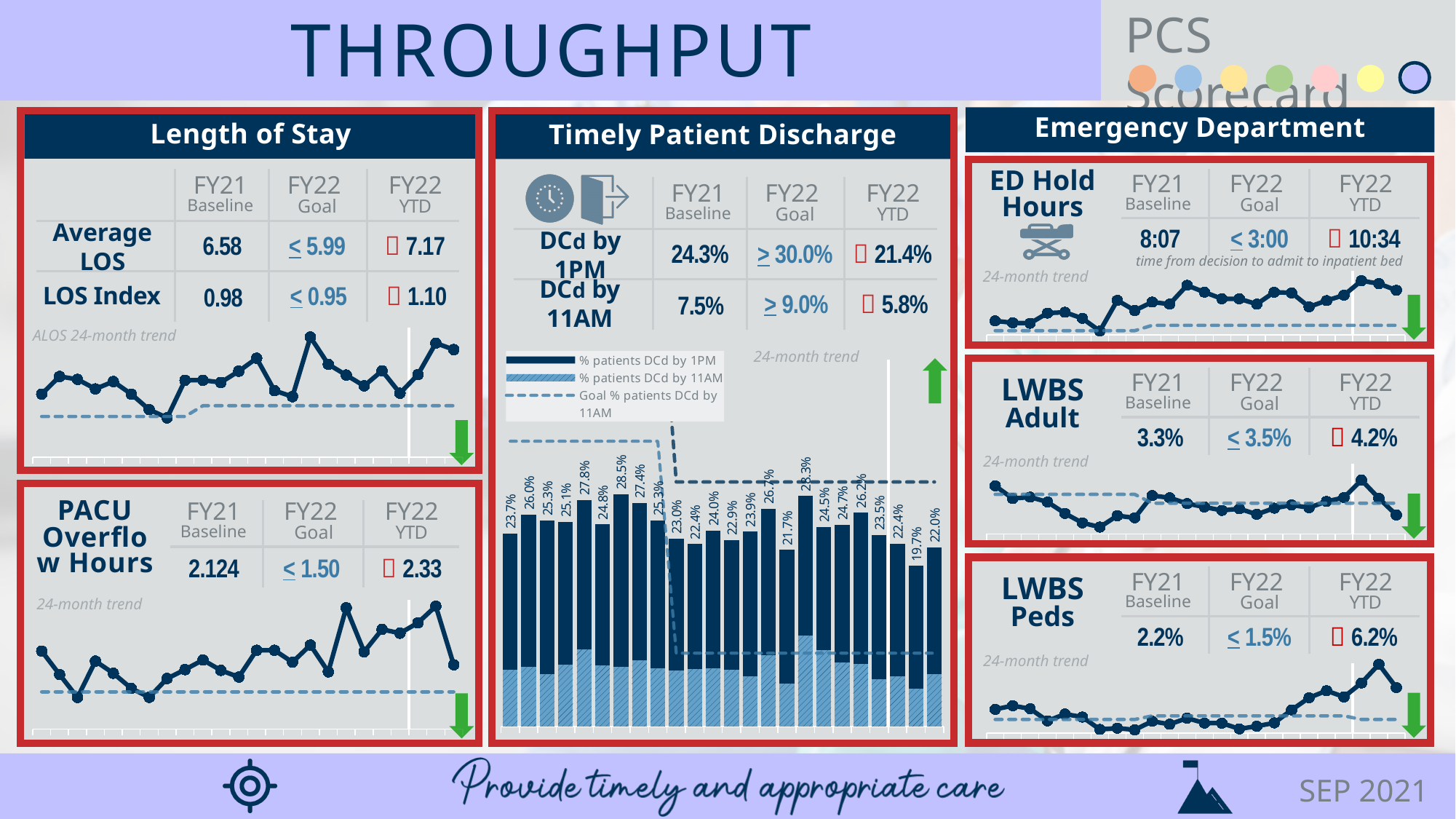
In the Timely Patient Discharge chart, which is larger: the first bar's value (23.7%) or the second bar's value (26.0%)? 26.0% In the LWBS Peds 24-month trend chart, do the values rise or fall over the last several months on the right side? rise In the Timely Patient Discharge chart, how many entries does the legend list? 3 In the Timely Patient Discharge chart, what is the highest labelled % patients DCd by 1PM value? 28.5% In the Timely Patient Discharge chart, what is the % patients DCd by 1PM value labelled on the first (leftmost) bar? 23.7% In the Timely Patient Discharge chart, what does the dashed line in the legend represent? Goal % patients DCd by 11AM In the Timely Patient Discharge chart, what kind of chart shows the % patients DCd by 1PM and by 11AM? bar chart In the Timely Patient Discharge chart, what is the lowest labelled % patients DCd by 1PM value? 19.7% What kind of chart is the ALOS 24-month trend in the Length of Stay panel? line chart In the Timely Patient Discharge chart, what is the % patients DCd by 1PM value labelled on the last (rightmost) bar? 22.0% In the Timely Patient Discharge chart, how many monthly bars are plotted? 24 In the Timely Patient Discharge chart, what is the difference between the highest labelled bar (28.5%) and the lowest labelled bar (19.7%)? 8.8 percentage points